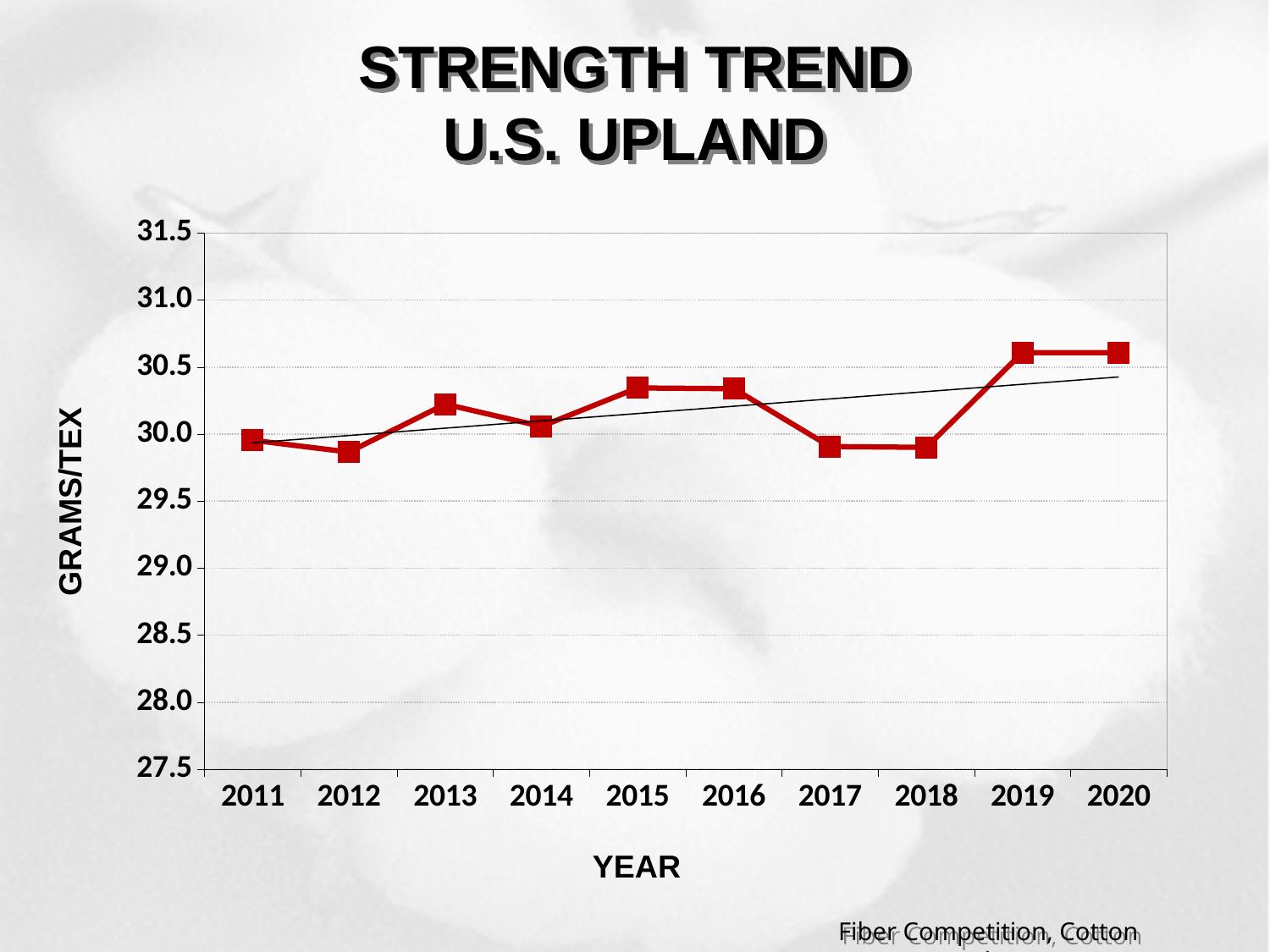
How many years are plotted on the x axis? 10 Is the value for 2015 greater or less than 30.0? greater Is the value for 2012 greater or less than 30.0? less What is the title of the chart? STRENGTH TREND U.S. UPLAND Which year has the larger value, 2012 or 2013? 2013 Does the fitted trend line rise or fall from 2011 to 2020? rise Is the value for 2017 greater or less than 30.0? less What kind of chart is shown on the slide? line chart What is the label on the y axis? GRAMS/TEX Which year has the larger value, 2015 or 2017? 2015